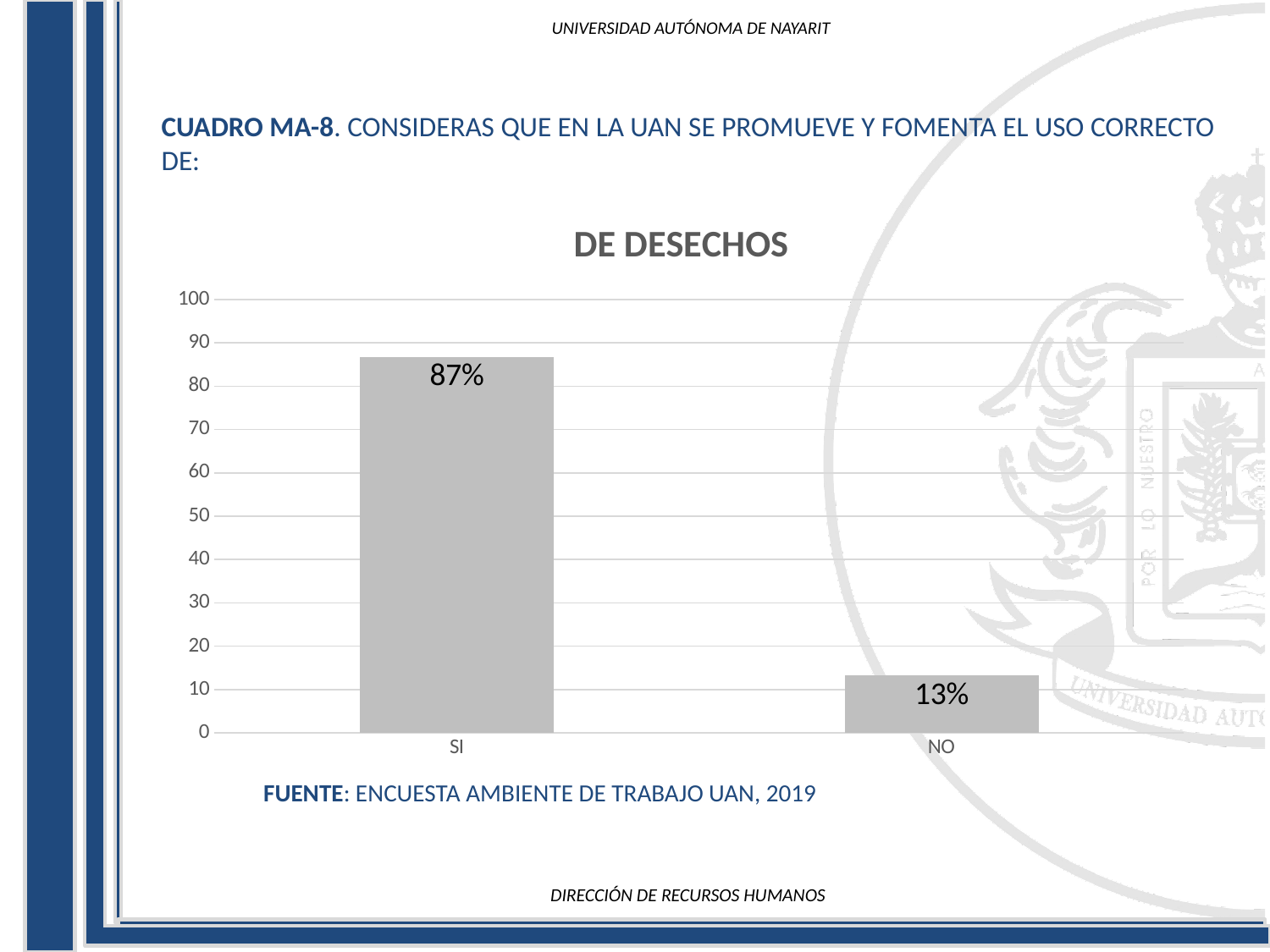
What is the source cited below the chart? ENCUESTA AMBIENTE DE TRABAJO UAN, 2019 How many categories are shown on the x axis? 2 What is the difference between the values for SI and NO? 74% What is the title of the chart? DE DESECHOS Which category has the lowest value? NO Is the value for SI greater or less than 80? greater What kind of chart is shown? bar chart Which category has the highest value? SI Which is larger, the value for SI or the value for NO? SI What is the value for NO? 13% What is the value for SI? 87% Is the value for NO greater or less than 20? less